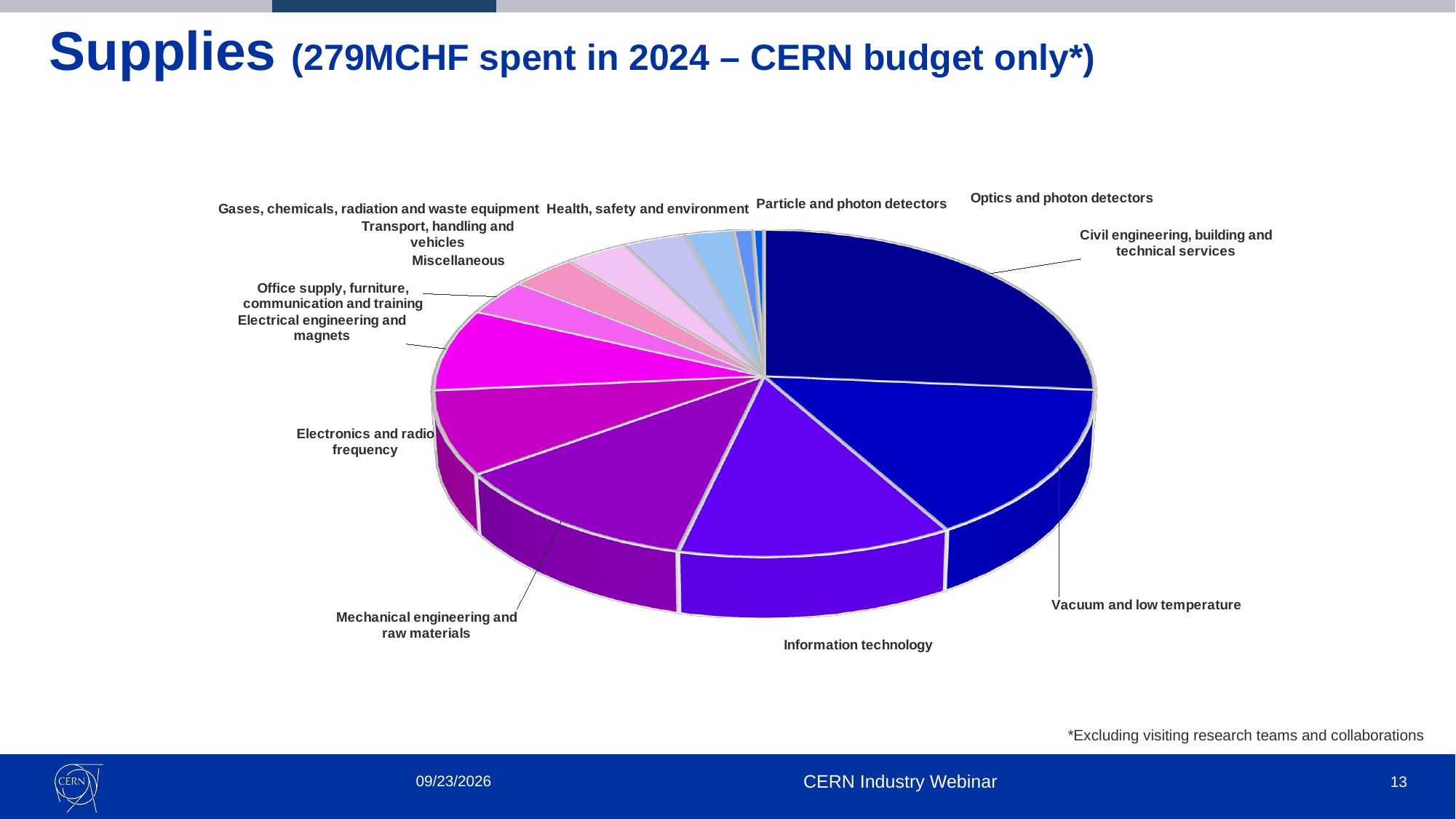
What is the title of the slide containing the pie chart? Supplies (279MCHF spent in 2024 – CERN budget only*) How many categories (slices) does the pie chart have? 13 What total amount of supplies spending in 2024 does the slide title state? 279MCHF What kind of chart is shown on the slide? Pie chart Which slice is larger: Vacuum and low temperature or Health, safety and environment? Vacuum and low temperature Which slice is larger: Electronics and radio frequency or Miscellaneous? Electronics and radio frequency Which slice is larger: Information technology or Electronics and radio frequency? Information technology Which category has the largest slice of the pie chart? Civil engineering, building and technical services